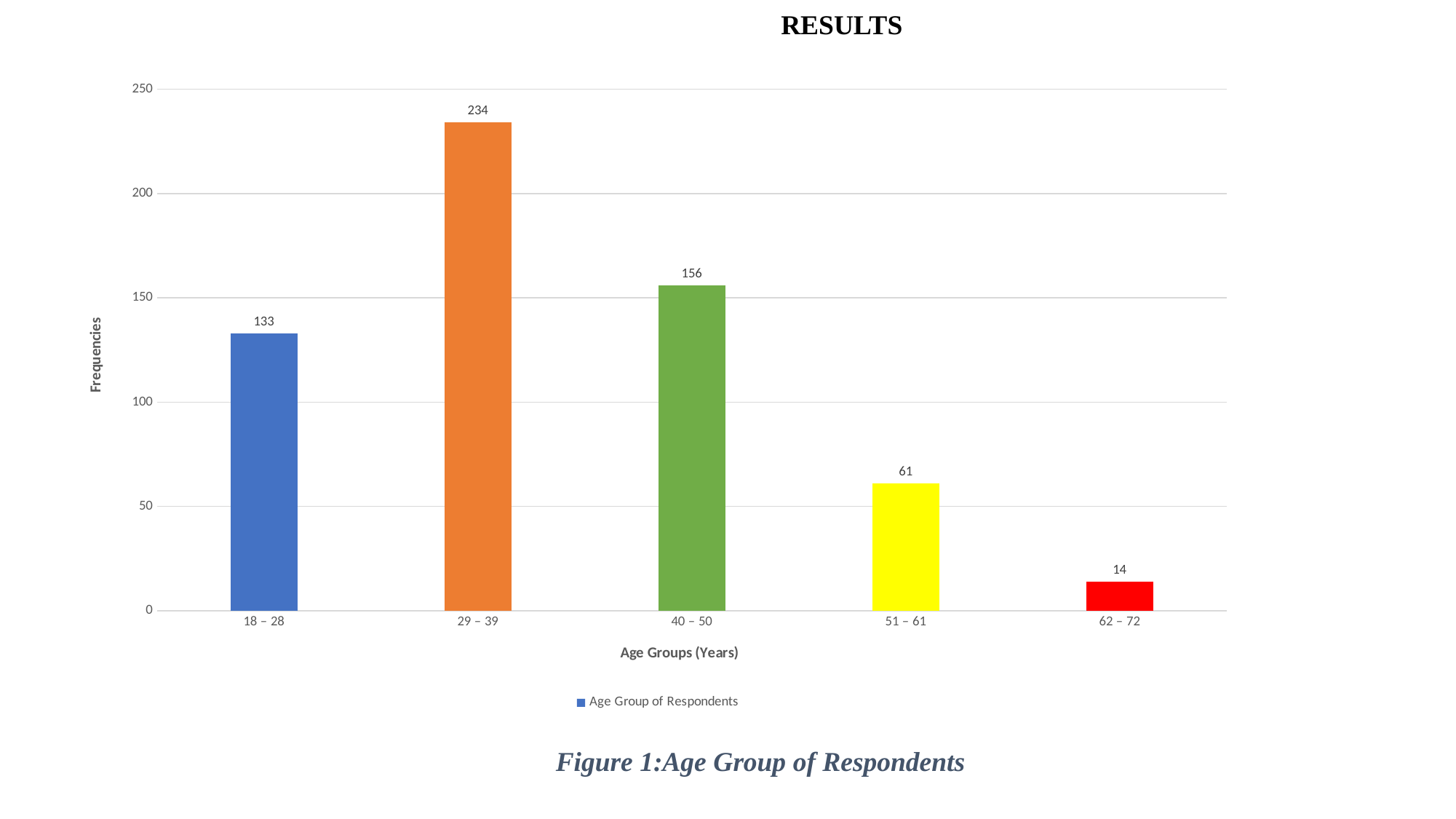
Which age group has the lowest frequency? 62 – 72 What kind of chart is shown on the slide? Bar chart What is the frequency for the 18 – 28 age group? 133 What is the label of the x axis? Age Groups (Years) Which age group has the highest frequency? 29 – 39 Which age group has a higher frequency, 18 – 28 or 40 – 50? 40 – 50 Is the frequency for the 51 – 61 age group greater or less than 100? less What is the difference in frequency between the 51 – 61 and 62 – 72 age groups? 47 What is the frequency for the 29 – 39 age group? 234 What is the frequency for the 62 – 72 age group? 14 What is the difference in frequency between the 29 – 39 and 40 – 50 age groups? 78 How many age groups are shown on the chart? 5